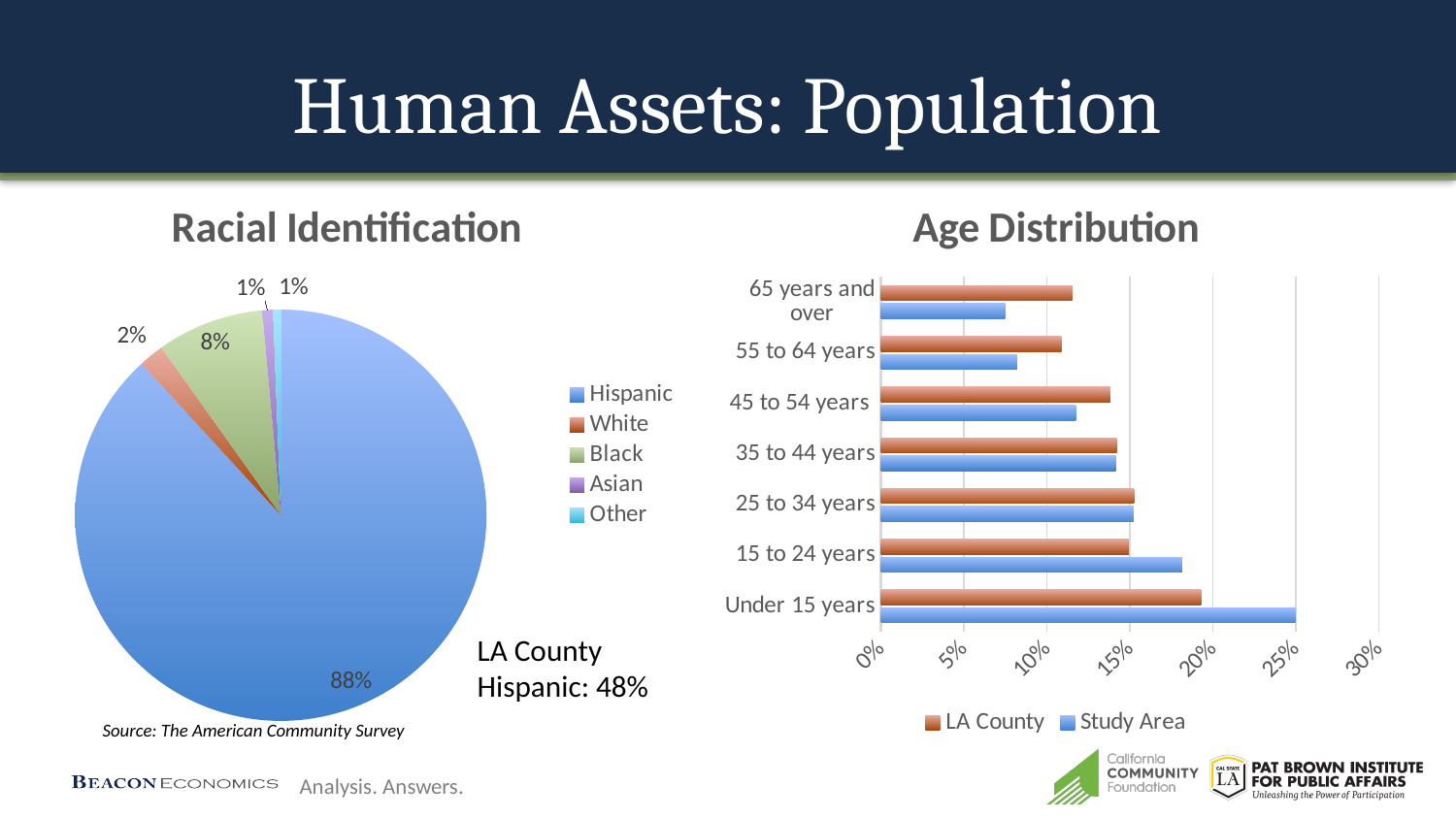
In the Racial Identification pie chart, which category has the largest slice? Hispanic In the Age Distribution chart, for Under 15 years, which is larger: LA County or Study Area? Study Area In the Age Distribution chart, is the Study Area value for 65 years and over greater or less than 10%? less In the Racial Identification pie chart, what percentage is shown for Hispanic? 88% In the Racial Identification chart, how many categories does the legend list? 5 In the Age Distribution chart, how many series does the legend list? 2 In the Racial Identification pie chart, what percentage is shown for Black? 8% What kind of chart is the Racial Identification chart? Pie chart In the Age Distribution chart, is the Study Area value for Under 15 years greater or less than 20%? greater What kind of chart is the Age Distribution chart? Bar chart In the Age Distribution chart, how many age groups are shown? 7 In the Racial Identification pie chart, what percentage is shown for White? 2%